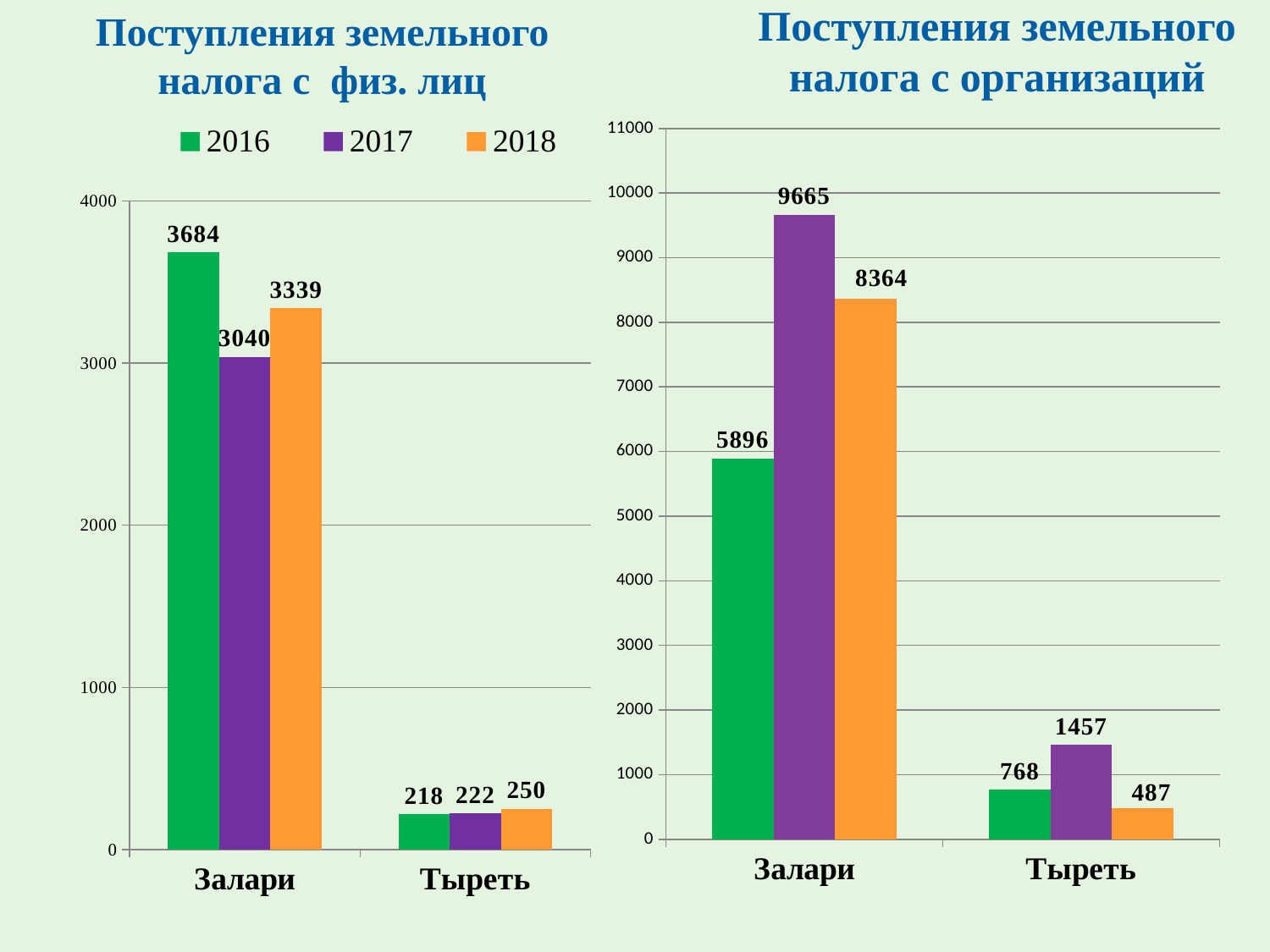
In the chart titled 'Поступления земельного налога с физ. лиц', what is the value for Тыреть in 2018? 250 In the chart titled 'Поступления земельного налога с физ. лиц', is the 2017 value for Залари greater or less than 3000? greater In the chart titled 'Поступления земельного налога с организаций', what is the difference between the purple and green bars for Залари? 3769 In the chart titled 'Поступления земельного налога с организаций', what is the value of the purple bar for Залари? 9665 In the chart titled 'Поступления земельного налога с организаций', what is the value of the orange bar for Тыреть? 487 In the chart titled 'Поступления земельного налога с физ. лиц', what is the difference between the 2016 and 2018 values for Залари? 345 In the chart titled 'Поступления земельного налога с физ. лиц', how many series does the legend list? 3 In the chart titled 'Поступления земельного налога с организаций', which is larger: the green bar for Тыреть or the orange bar for Тыреть? the green bar (768) In the chart titled 'Поступления земельного налога с физ. лиц', which year has the lowest value for Залари? 2017 In the chart titled 'Поступления земельного налога с организаций', which bar for Тыреть is the highest? the purple bar (1457) In the chart titled 'Поступления земельного налога с физ. лиц', what is the value for Залари in 2016? 3684 What type of chart is the chart titled 'Поступления земельного налога с организаций'? bar chart